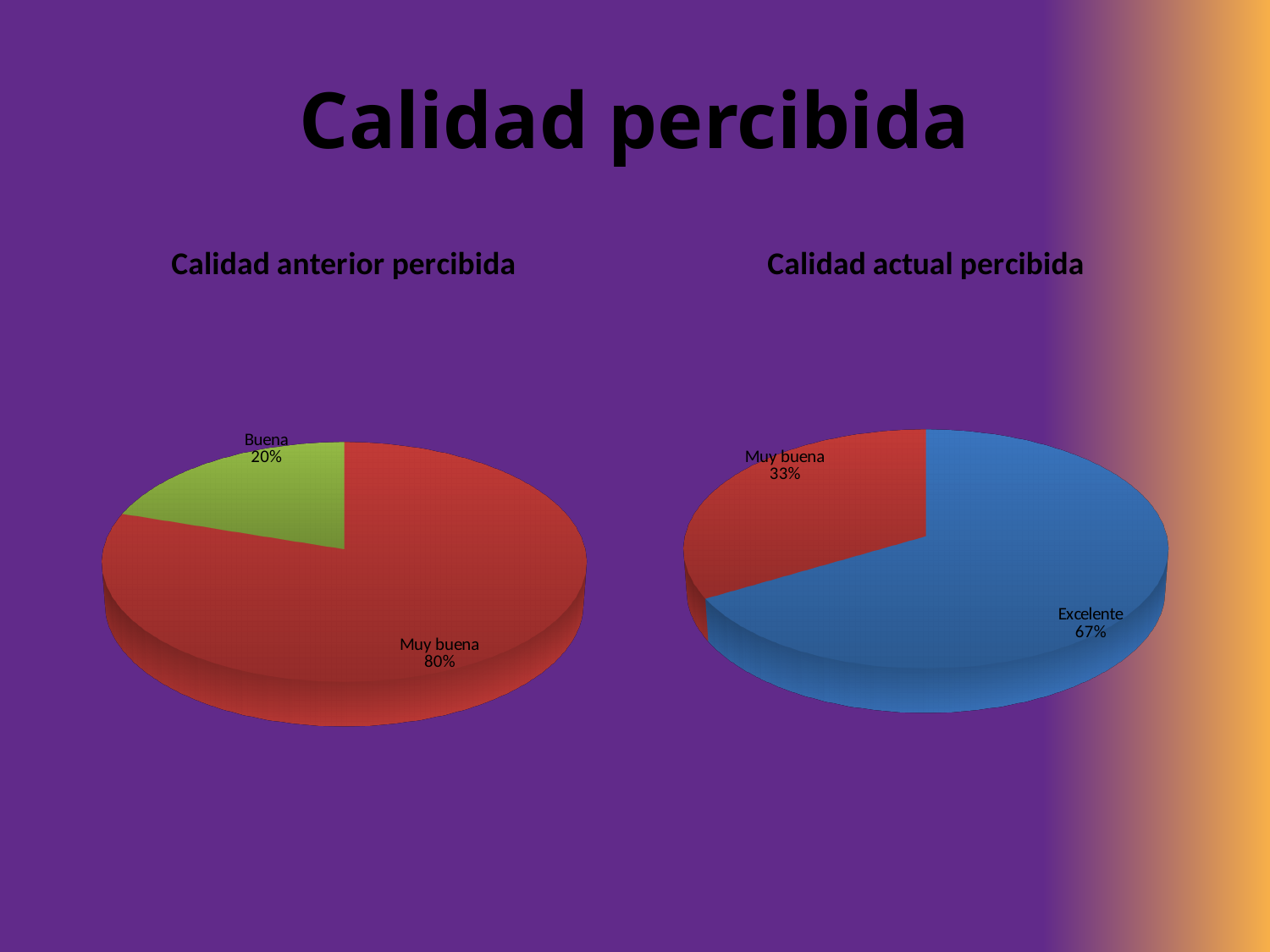
In the 'Calidad anterior percibida' chart, what share does 'Buena' have? 20% In the 'Calidad anterior percibida' chart, what is the difference between the 'Muy buena' and 'Buena' shares? 60% In the 'Calidad actual percibida' chart, what share does 'Excelente' have? 67% What kind of chart is the 'Calidad actual percibida' chart? Pie chart In the 'Calidad anterior percibida' chart, what share does 'Muy buena' have? 80% In the 'Calidad actual percibida' chart, what is the difference between the 'Excelente' and 'Muy buena' shares? 34% In the 'Calidad actual percibida' chart, which is larger, 'Excelente' or 'Muy buena'? Excelente How many slices does the 'Calidad anterior percibida' chart have? 2 In the 'Calidad actual percibida' chart, which category has the smallest slice? Muy buena In the 'Calidad anterior percibida' chart, which category has the largest slice? Muy buena What is the title of the chart on the left of the slide? Calidad anterior percibida